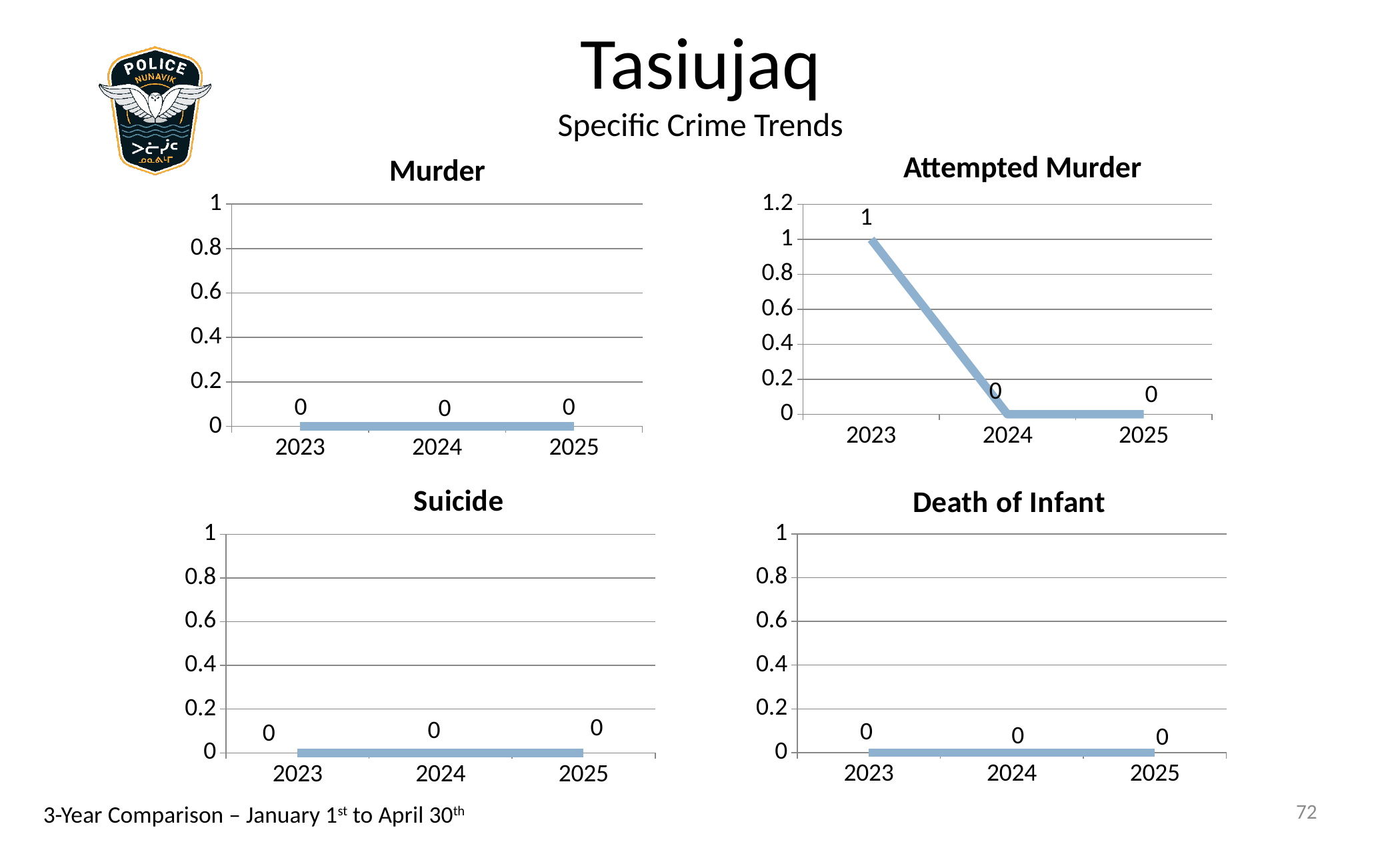
How many years are plotted in the Suicide chart? 3 In the Attempted Murder chart, is the value for 2023 greater or less than 0.6? greater In the Attempted Murder chart, what is the difference between the 2023 and 2025 values? 1 In the Attempted Murder chart, do the values rise or fall from 2023 to 2024? fall How many charts are shown on the slide? 4 What kind of chart is the Attempted Murder chart? line chart In the Attempted Murder chart, what is the value for 2024? 0 In the Murder chart, what is the value for 2025? 0 In the Attempted Murder chart, which year has the highest value? 2023 In the Suicide chart, what is the value for 2024? 0 In the Death of Infant chart, what is the value for 2023? 0 In the Attempted Murder chart, what is the value for 2023? 1